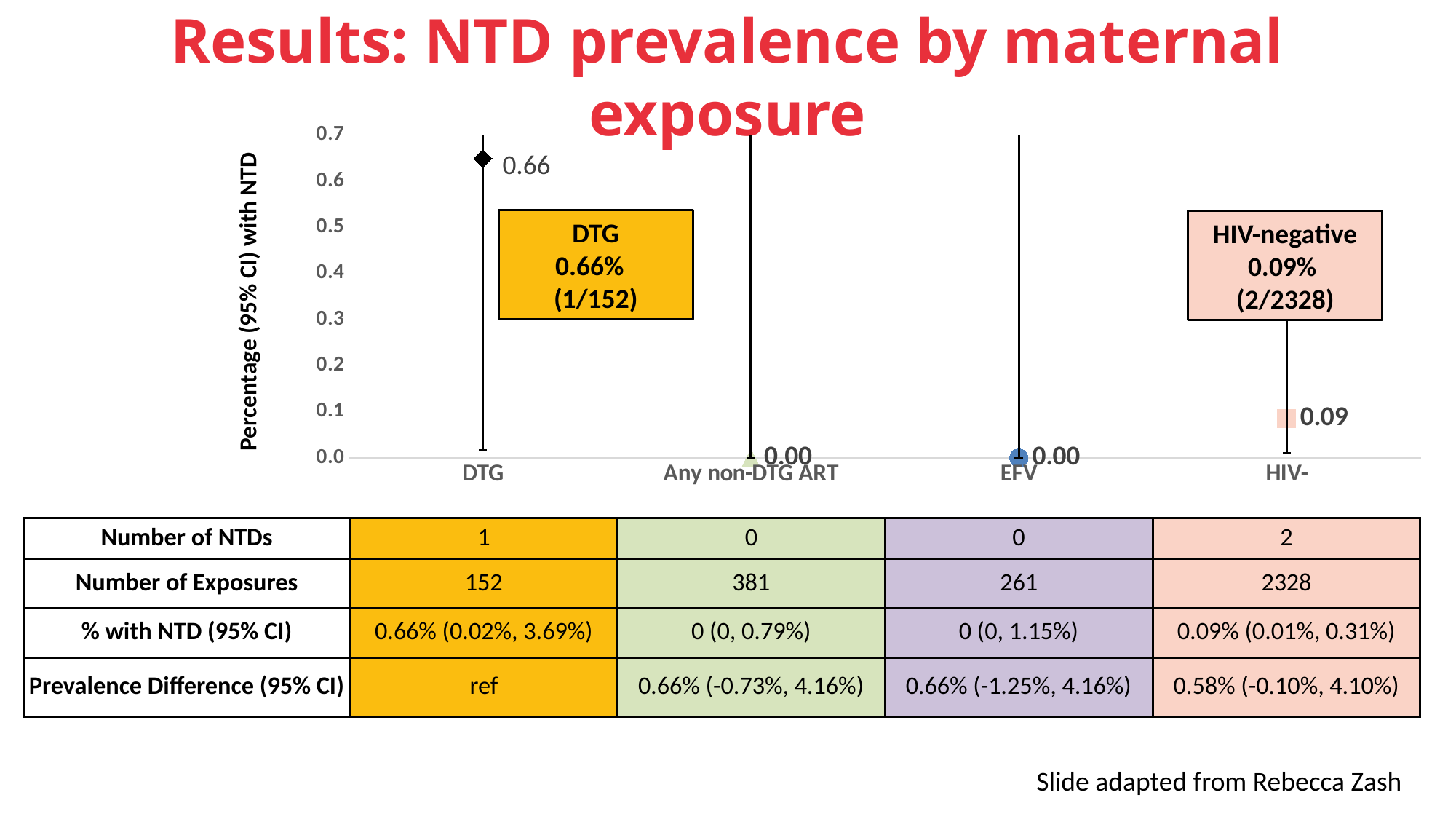
Which category has the highest plotted value? DTG Is the plotted value for DTG greater or less than 0.5? greater What is the highest tick value shown on the y axis? 0.7 What is the plotted value for DTG? 0.66 What fraction is shown in the callout box for HIV-negative? 2/2328 How many categories are shown on the x axis of the chart? 4 What is the difference between the plotted values for DTG and HIV-? 0.57 What is the plotted value for Any non-DTG ART? 0.00 Which has a larger plotted value, DTG or HIV-? DTG What is the plotted value for EFV? 0.00 What is the plotted value for HIV-? 0.09 What is the label of the chart's y axis? Percentage (95% CI) with NTD